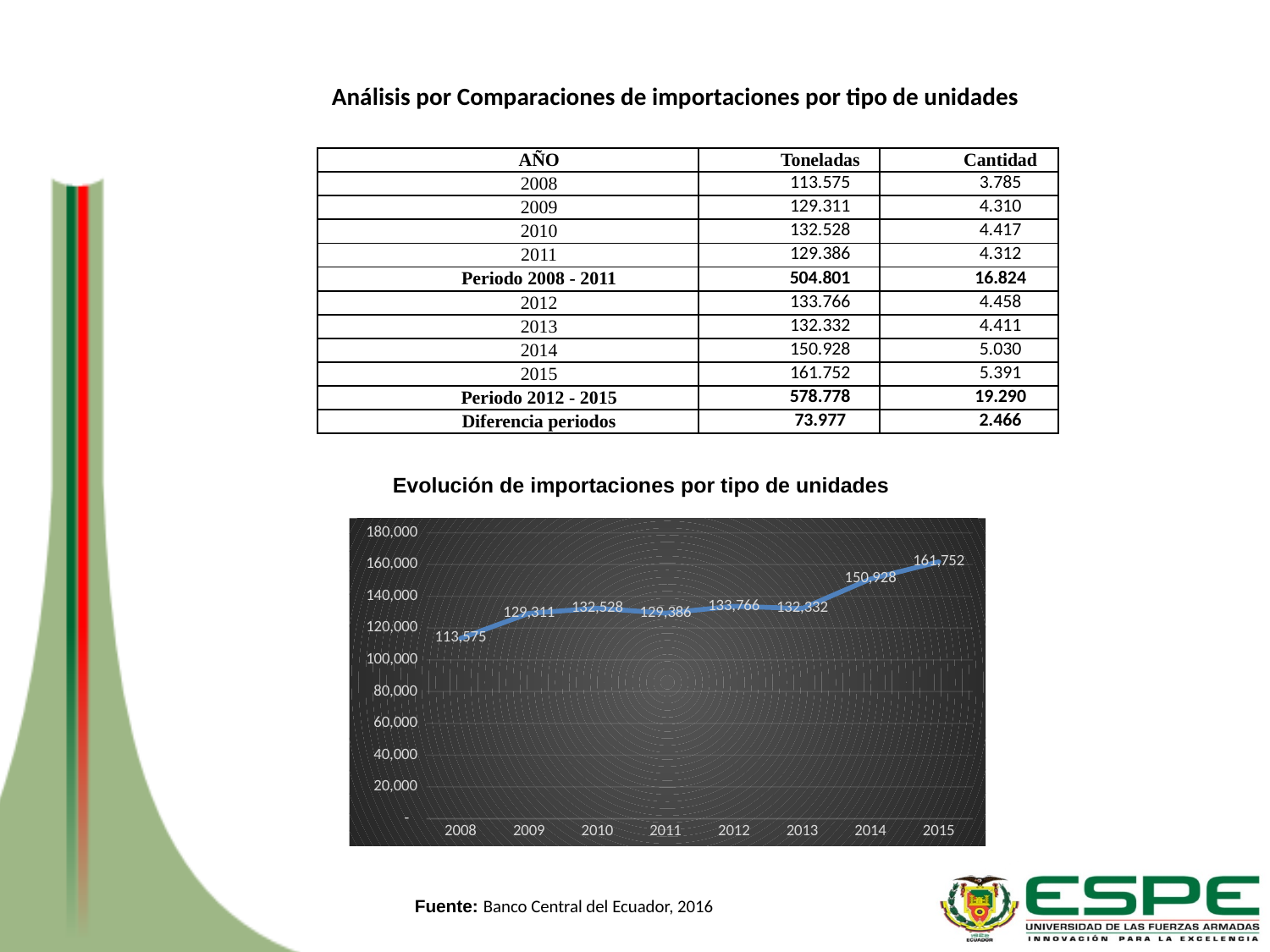
What type of chart is shown under the title "Evolución de importaciones por tipo de unidades"? line chart Which year has the highest value in the chart? 2015 Does the line in the chart generally rise or fall from 2008 to 2015? rise Is the value for 2012 in the chart greater or less than 140,000? less What is the value plotted for 2011 in the chart? 129,386 How many years are plotted on the x axis of the chart? 8 Which year has the lowest value in the chart? 2008 What is the difference between the values for 2015 and 2014 in the chart? 10,824 What is the value plotted for 2014 in the chart? 150,928 Which year has the larger value in the chart, 2010 or 2013? 2010 What is the highest value shown on the y axis of the chart? 180,000 What is the value plotted for 2008 in the chart? 113,575